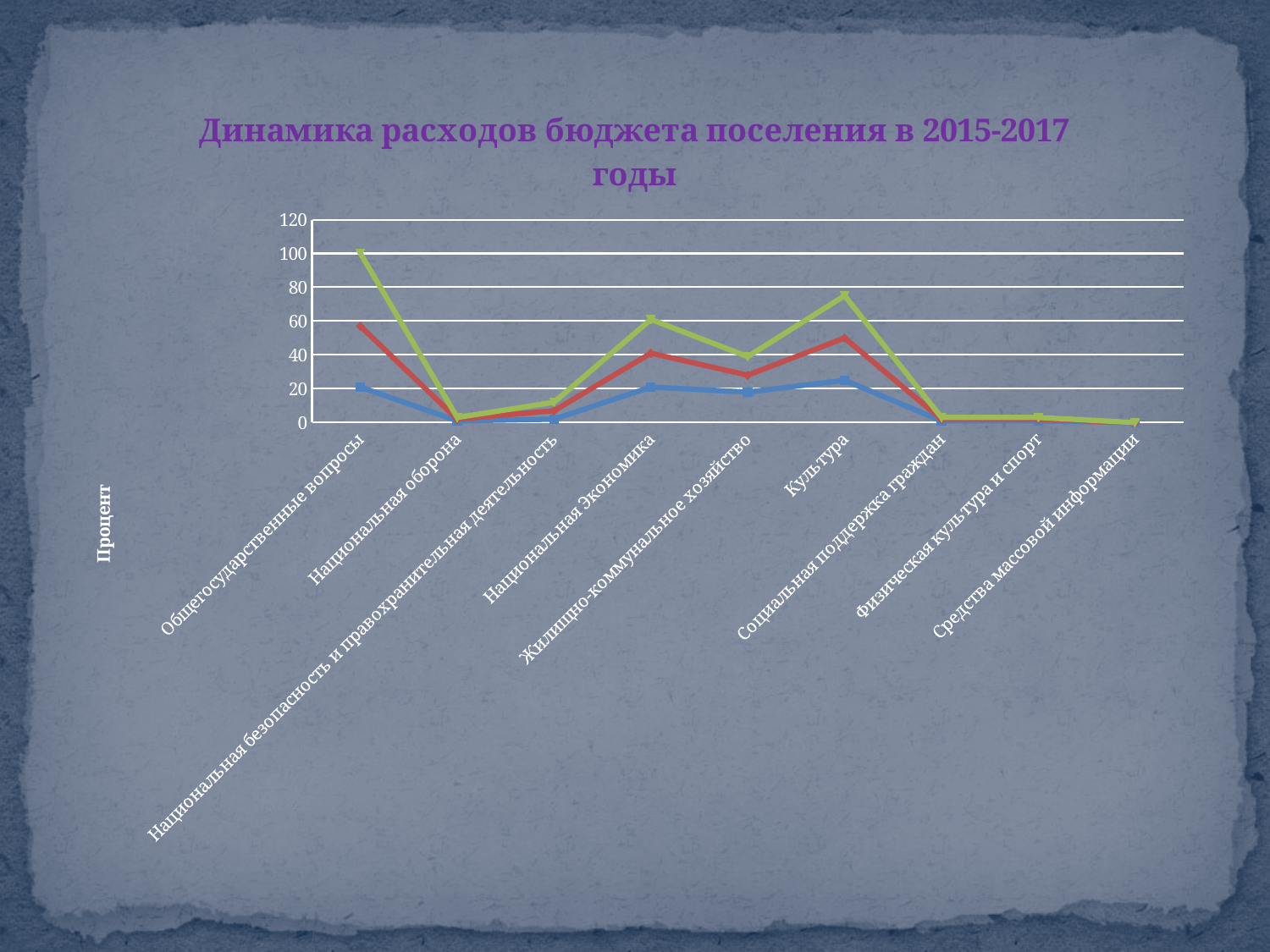
What is the label on the vertical axis of the chart? Процент For the green line, which category has the highest value? Общегосударственные вопросы Is the value of the red line for Общегосударственные вопросы greater or less than 40? greater Is the value of the green line for Национальная экономика greater or less than 40? greater Is the value of the blue line for Культура greater or less than 40? less How many lines (data series) are plotted on the chart? 3 At Культура, which line has the larger value: the red line or the blue line? the red line How many categories are shown along the x axis of the chart? 9 On the green line, which is larger: the value for Культура or the value for Национальная экономика? Культура What is the title of the chart? Динамика расходов бюджета поселения в 2015-2017 годы What kind of chart is shown on the slide? line chart